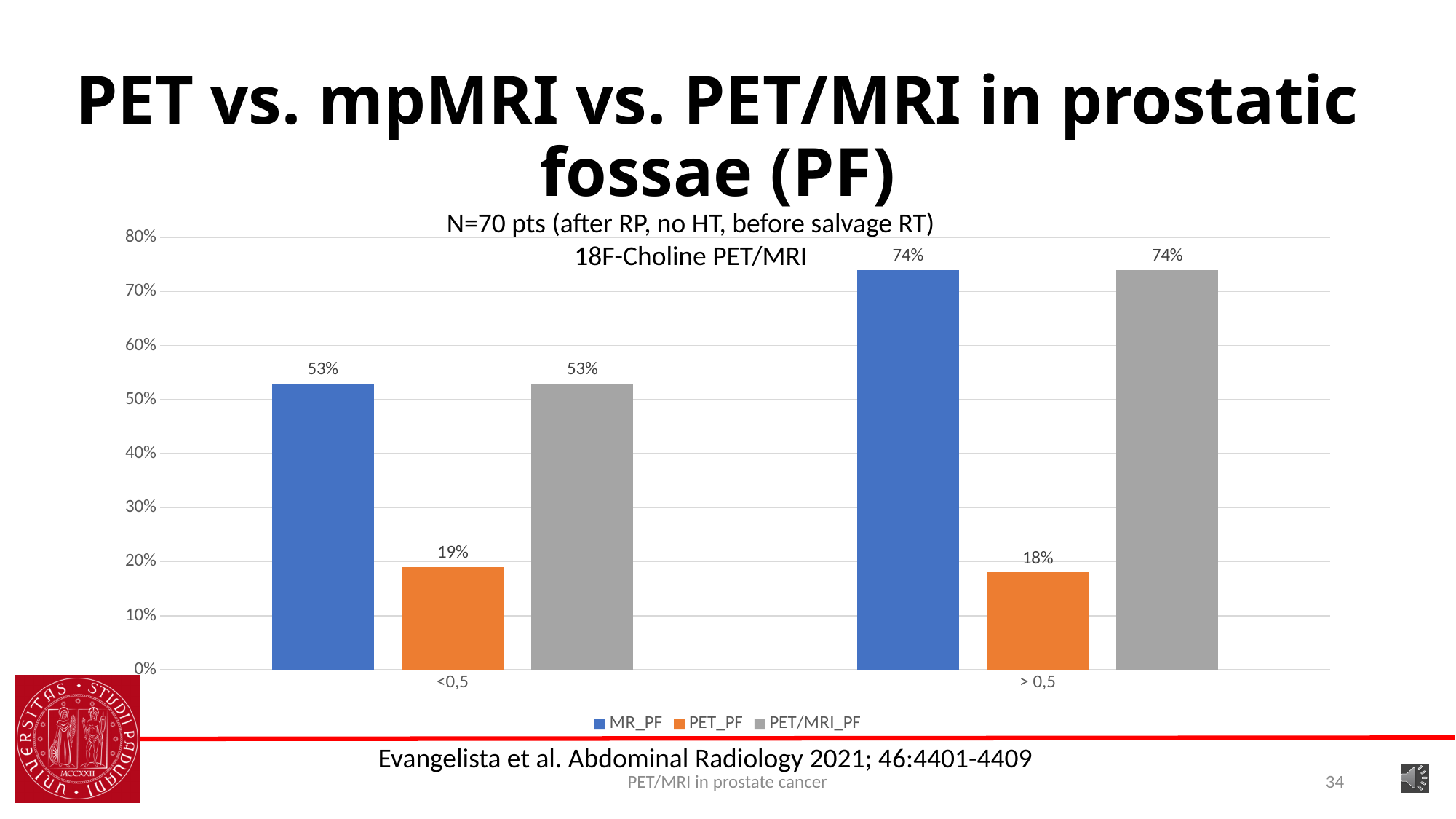
Which series has the lowest value in the > 0,5 category? PET_PF Which is larger: PET_PF for <0,5 or PET_PF for > 0,5? PET_PF for <0,5 What is the value for MR_PF in the <0,5 category? 53% What is the difference between the MR_PF values for > 0,5 and <0,5? 21% What is the value for PET_PF in the <0,5 category? 19% What kind of chart is shown on the slide? Bar chart What is the value for PET_PF in the > 0,5 category? 18% What is the difference between MR_PF and PET_PF in the <0,5 category? 34% How many categories are shown on the x axis? 2 How many series does the legend list? 3 What is the value for PET/MRI_PF in the > 0,5 category? 74% Which colour represents the PET_PF series in the legend? Orange